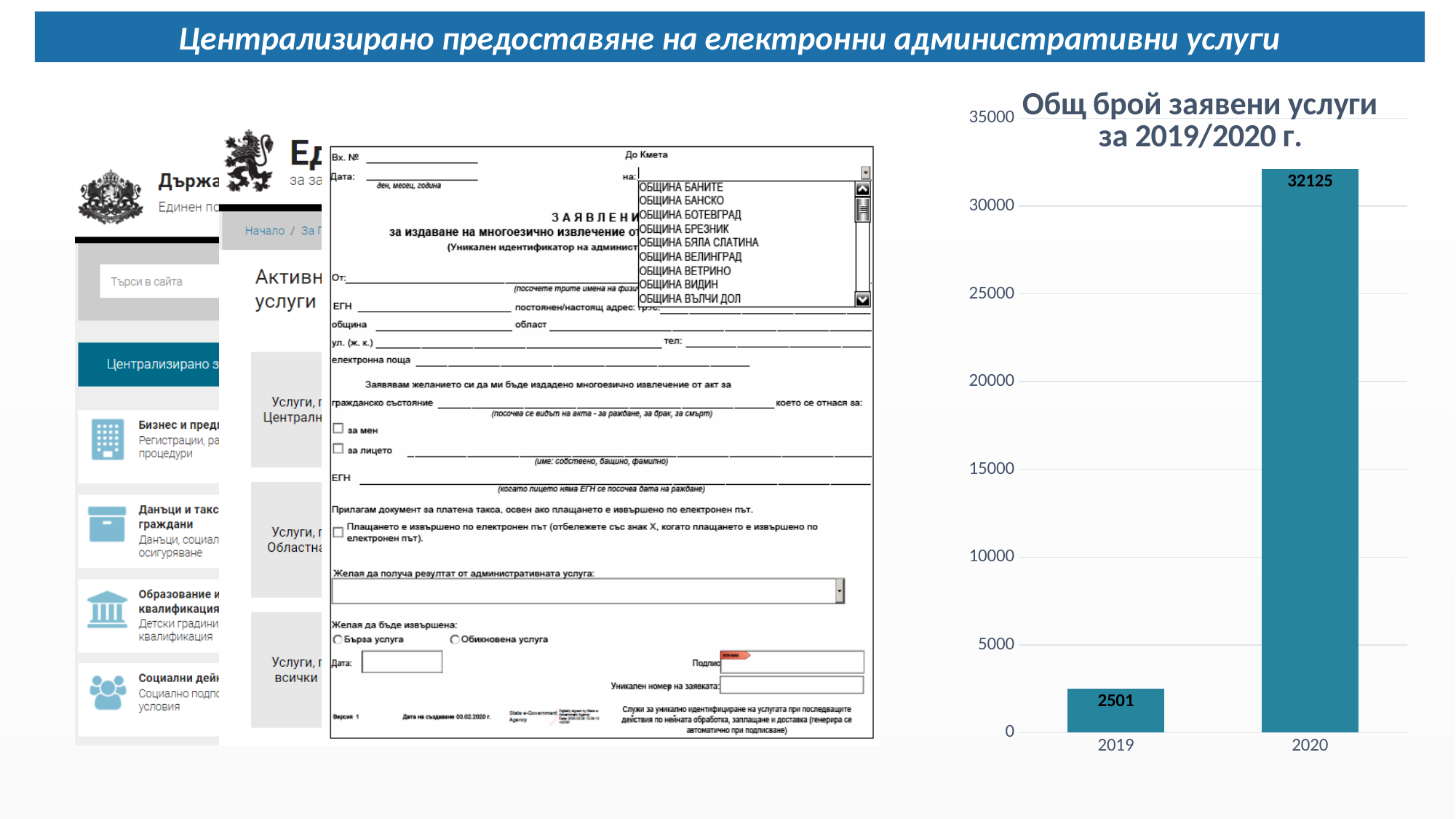
What is the value for 2019? 2501 Which year has the highest value? 2020 Is the value for 2020 greater or less than 30000? greater What kind of chart is shown on the slide? bar chart What is the value for 2020? 32125 Is the value for 2019 greater or less than 5000? less Which is larger, the value for 2019 or the value for 2020? 2020 Do the values rise or fall from 2019 to 2020? rise Which year has the lowest value? 2019 What is the title of the chart? Общ брой заявени услуги за 2019/2020 г. What is the difference between the values for 2020 and 2019? 29624 How many categories are shown on the x axis? 2